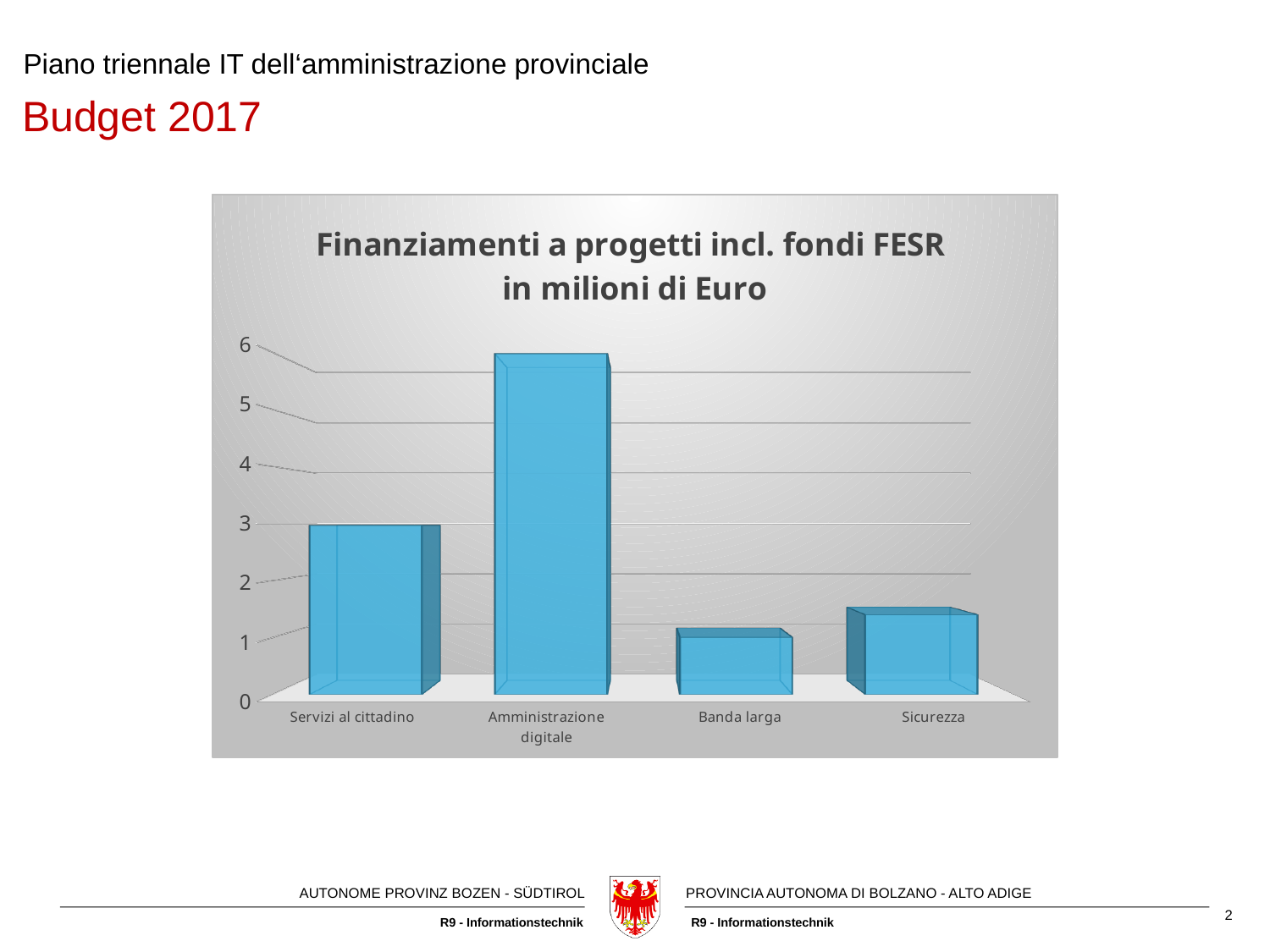
Is the value for Servizi al cittadino greater or less than 2? greater What kind of chart is shown on the slide? bar chart How many categories are shown on the x axis of the chart? 4 Is the value for Amministrazione digitale greater or less than 5? greater Which category has the lowest value? Banda larga Is the value for Banda larga greater or less than 2? less What is the title of the chart? Finanziamenti a progetti incl. fondi FESR in milioni di Euro Which category has the highest value? Amministrazione digitale Which is larger, the value for Amministrazione digitale or the value for Banda larga? Amministrazione digitale Which is larger, the value for Servizi al cittadino or the value for Sicurezza? Servizi al cittadino